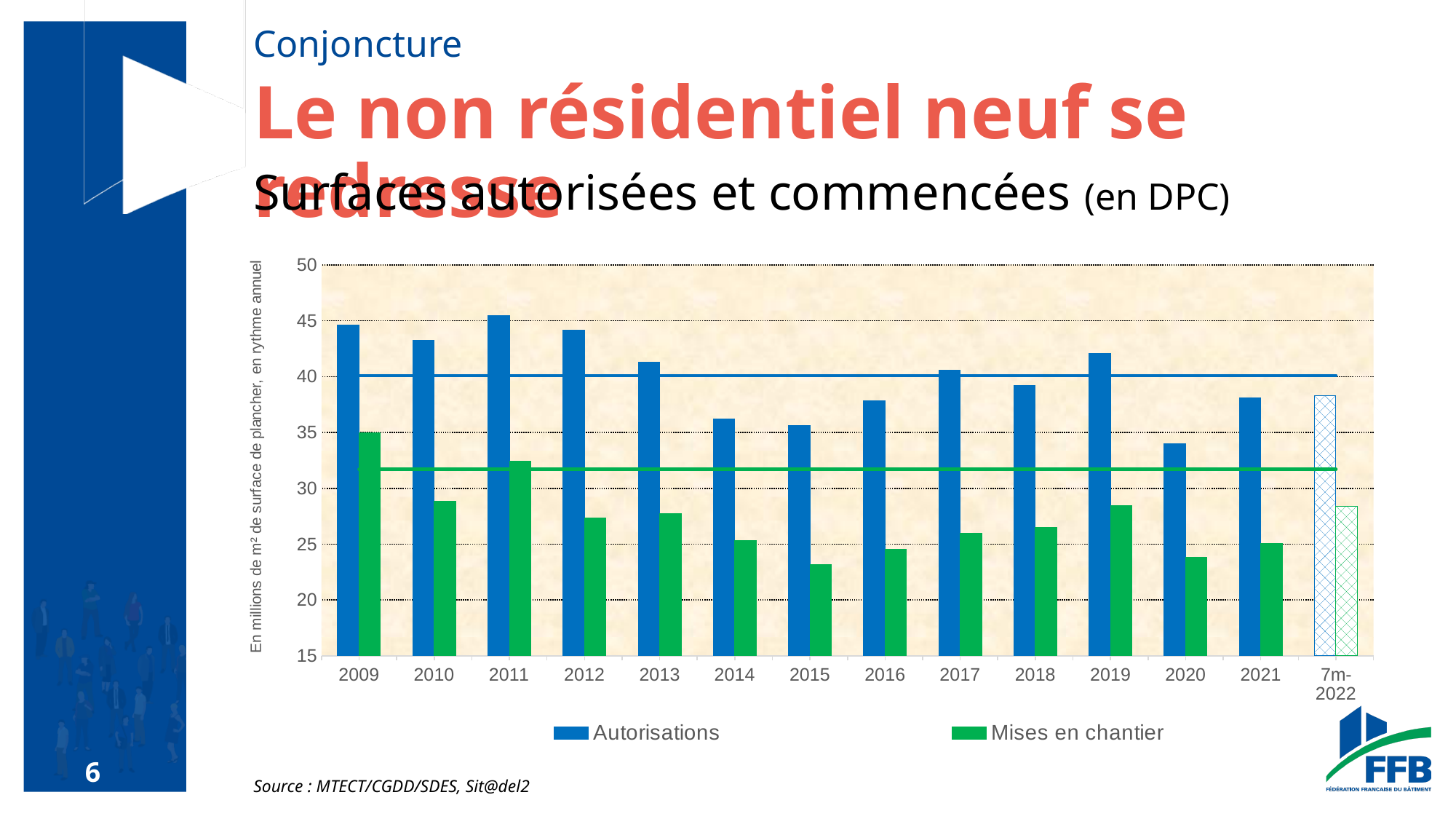
What kind of chart is shown on the slide? bar chart Do the Autorisations values generally rise or fall from 2009 to 2016? fall Which series is shown in green in the legend? Mises en chantier Which is larger, the Autorisations value for 2013 or for 2016? 2013 Is the Mises en chantier value for 2015 greater or less than 25? less In which year is the Autorisations bar highest? 2011 In which year is the Mises en chantier bar highest? 2009 How many categories are shown on the x axis? 14 How many series does the legend list? 2 In which year is the Autorisations bar lowest? 2020 Is the Autorisations value for 2009 greater or less than 40? greater Is the Autorisations value for 2020 greater or less than 35? less